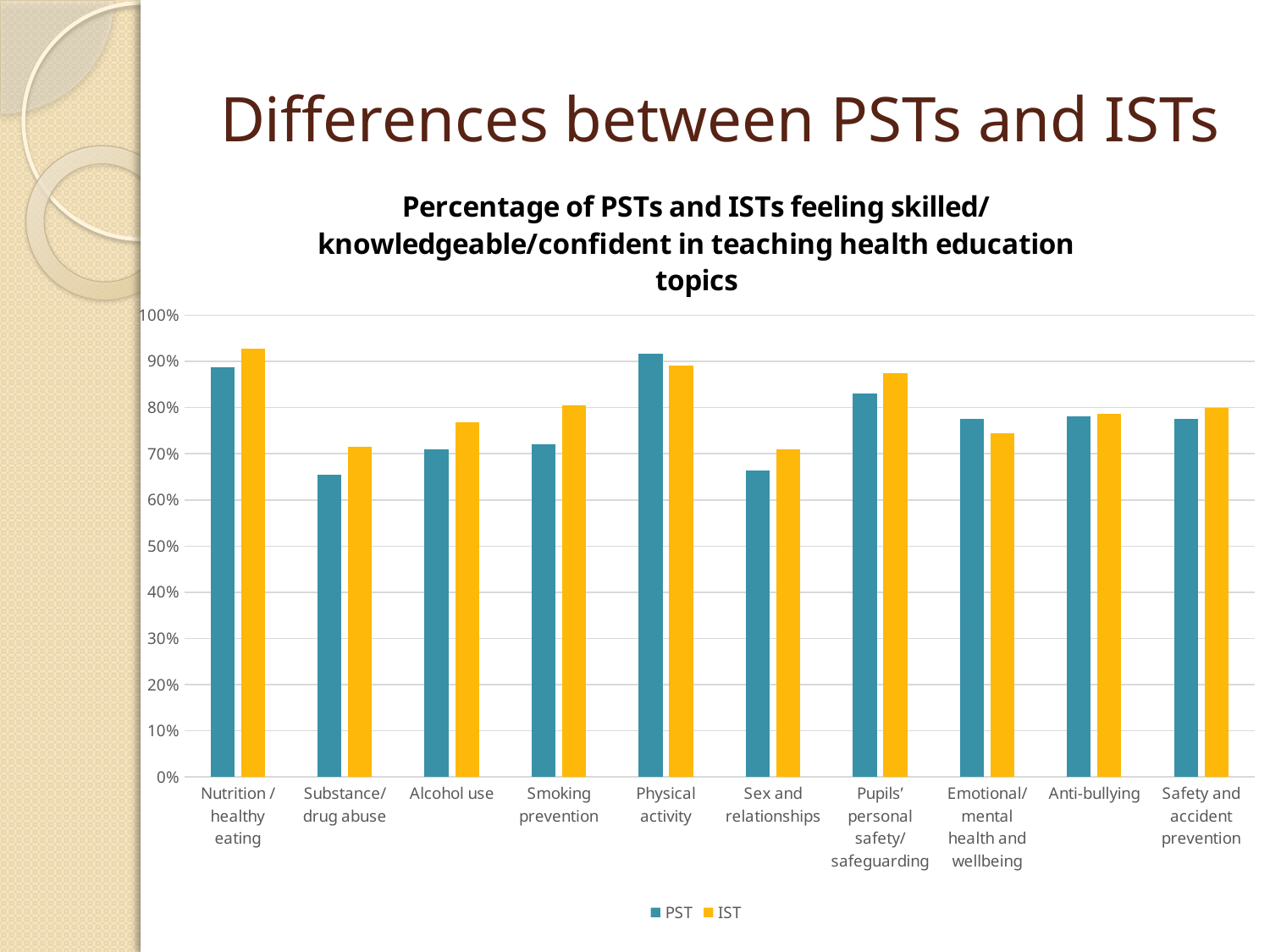
How many health education topics are shown on the x axis? 10 Is the IST value for Pupils' personal safety/ safeguarding greater or less than 80%? greater Which series is shown in orange? IST For Smoking prevention, which is larger: the PST value or the IST value? IST Which topic has the highest PST value? Physical activity Which topic has the highest IST value? Nutrition / healthy eating Is the PST value for Substance/ drug abuse greater or less than 70%? less For Physical activity, which is larger: the PST value or the IST value? PST Is the IST value for Nutrition / healthy eating greater or less than 90%? greater How many series does the legend list? 2 What kind of chart is shown on the slide? bar chart